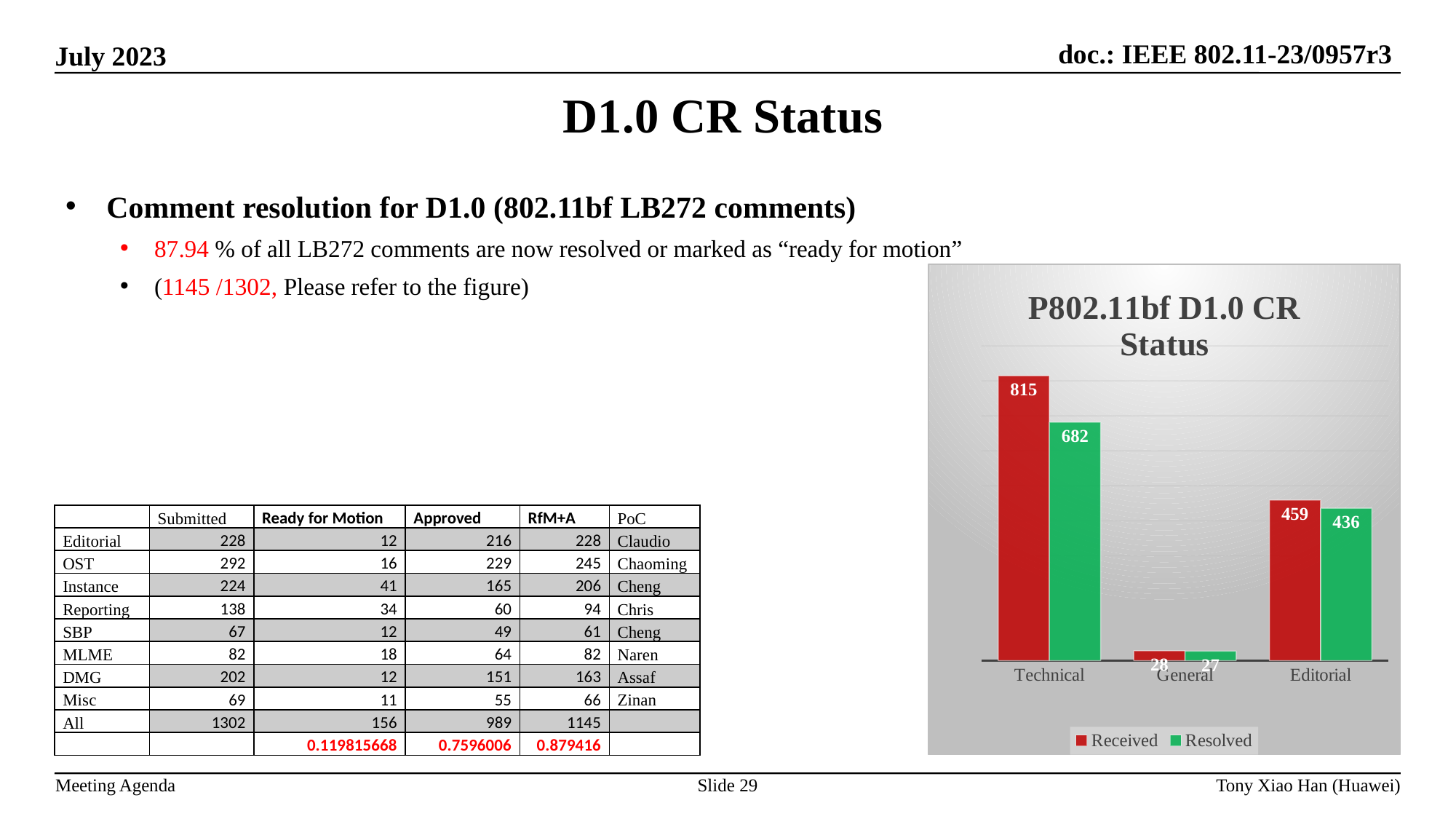
Is the Received value for Technical larger than the Received value for Editorial? Yes What is the Received value for Technical? 815 What is the Resolved value for Editorial? 436 Which category has the lowest Resolved value? General What is the Resolved value for General? 27 How many series does the legend list? 2 Which category has the highest Received value? Technical What is the difference between Received and Resolved for Editorial? 23 What is the difference between Received and Resolved for Technical? 133 What kind of chart is shown? Bar chart How many categories are shown on the x axis? 3 What is the title of the chart? P802.11bf D1.0 CR Status